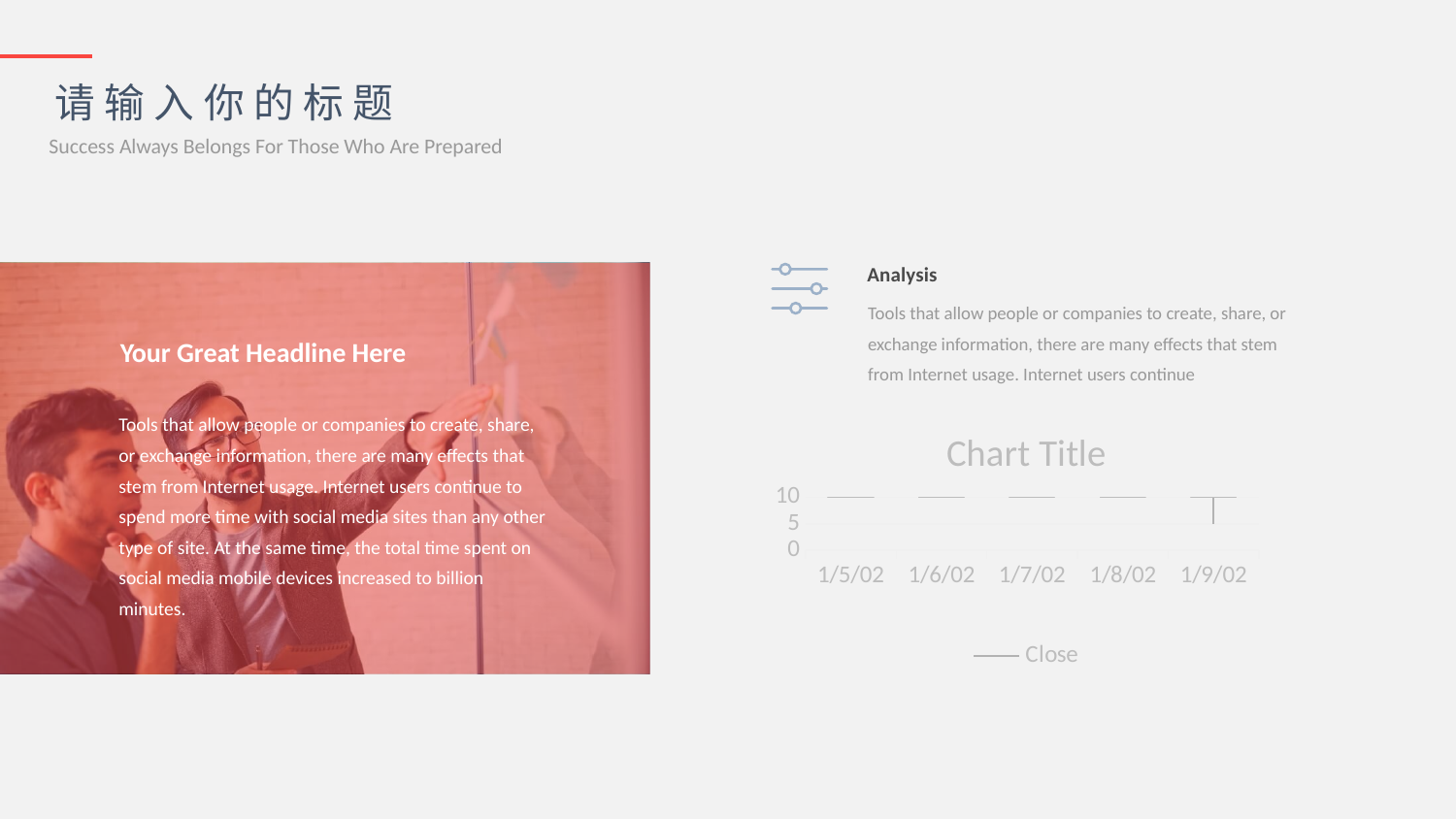
Is the Close value for 1/5/02 greater or less than 5? greater What is the first date shown on the x axis of the chart? 1/5/02 How many dates are shown on the x axis of the chart? 5 What is the last date shown on the x axis of the chart? 1/9/02 How many series does the chart legend list? 1 Is the Close value for 1/7/02 greater or less than 5? greater What is the highest value labelled on the y axis of the chart? 10 What is the title of the chart? Chart Title What series name appears in the chart legend? Close